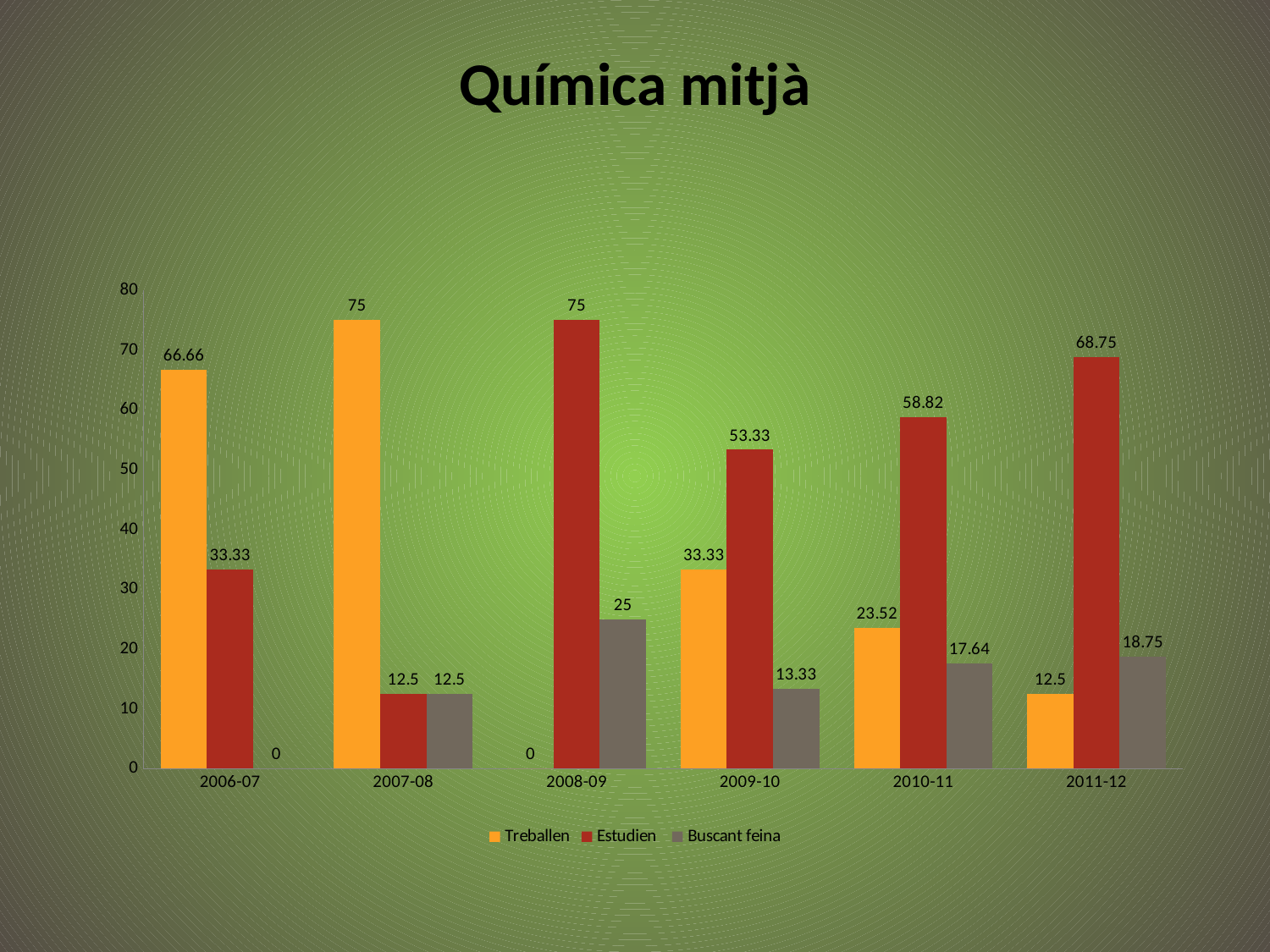
What is the value for Buscant feina in 2008-09? 25 In which year is the Buscant feina value lowest? 2006-07 Which is larger in 2009-10, Treballen or Estudien? Estudien What kind of chart is shown on the slide? Bar chart What is the value for Treballen in 2006-07? 66.66 What is the value for Estudien in 2010-11? 58.82 How many years are shown on the x axis? 6 In which year is the Estudien value highest? 2008-09 What is the title of the chart? Química mitjà What is the value for Treballen in 2008-09? 0 What is the difference between the Estudien and Treballen values in 2011-12? 56.25 How many series does the legend list? 3